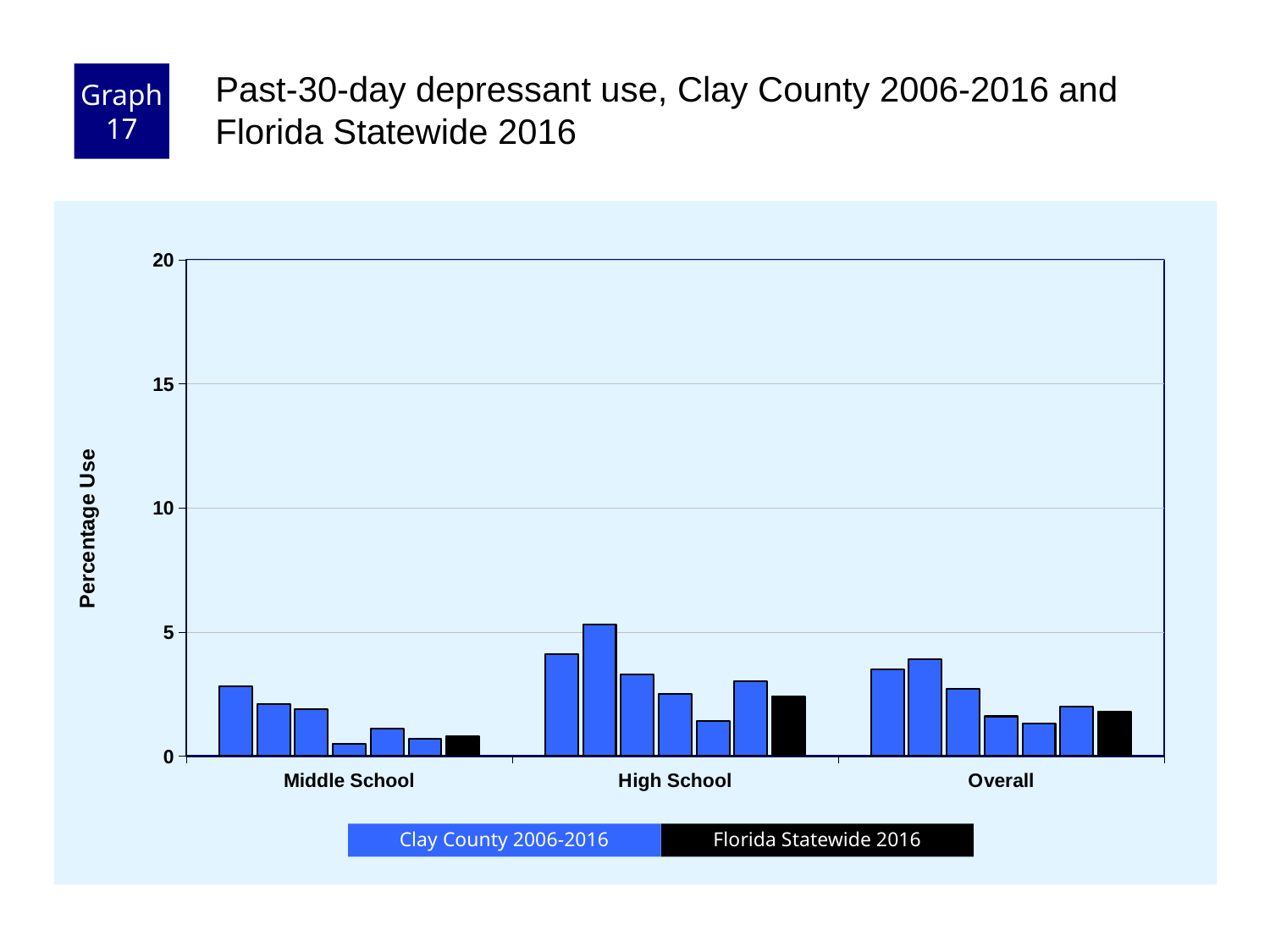
Which is larger: the Florida Statewide 2016 bar for Overall or the Florida Statewide 2016 bar for Middle School? Overall Is the Florida Statewide 2016 value for Middle School greater or less than 5? less Which category on the x axis contains the tallest bar in the chart? High School Which is larger: the Florida Statewide 2016 bar for High School or the Florida Statewide 2016 bar for Middle School? High School How many series does the chart legend list? 2 What kind of chart is shown on the slide? bar chart How many categories are shown on the x axis of the chart? 3 Is the Florida Statewide 2016 value for High School greater or less than 5? less What colour are the Florida Statewide 2016 bars in the chart? black What is the highest value shown on the y axis of the chart? 20 Are all the bars in the chart greater or less than 10? less What is the label on the y axis of the chart? Percentage Use